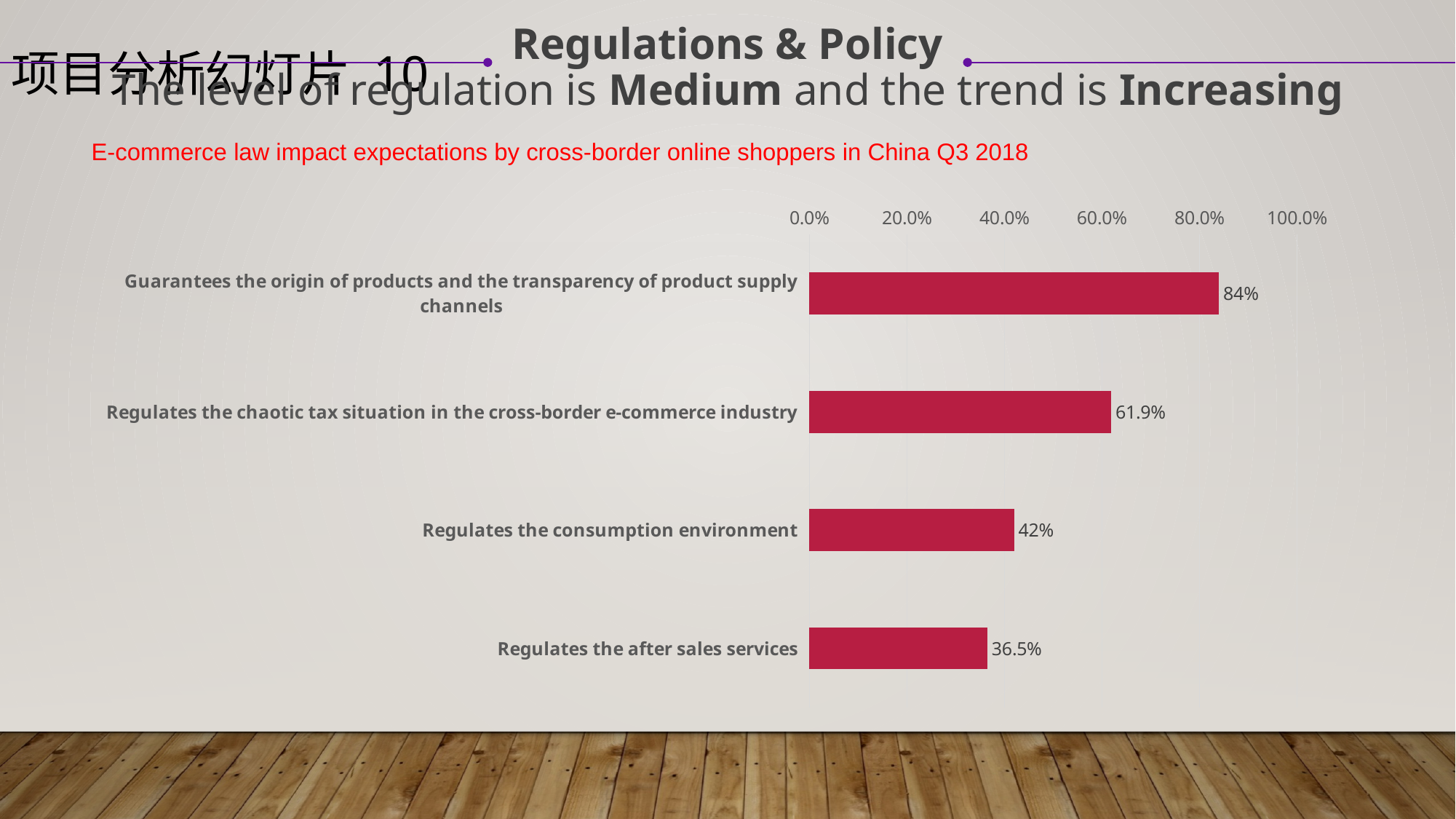
How many categories are shown in the chart? 4 Which is larger: the value for 'Regulates the consumption environment' or 'Regulates the after sales services'? Regulates the consumption environment What is the difference between the values for 'Regulates the chaotic tax situation in the cross-border e-commerce industry' and 'Regulates the consumption environment'? 19.9% Which category has the highest value? Guarantees the origin of products and the transparency of product supply channels Is the value for 'Regulates the chaotic tax situation in the cross-border e-commerce industry' greater or less than 60.0%? greater What is the value for 'Regulates the chaotic tax situation in the cross-border e-commerce industry'? 61.9% What is the title of the chart? E-commerce law impact expectations by cross-border online shoppers in China Q3 2018 What is the value for 'Regulates the consumption environment'? 42% What is the value for 'Regulates the after sales services'? 36.5% What percentage of shoppers expect the e-commerce law to guarantee the origin of products and the transparency of product supply channels? 84% Which category has the lowest value? Regulates the after sales services What kind of chart is shown on the slide? Bar chart